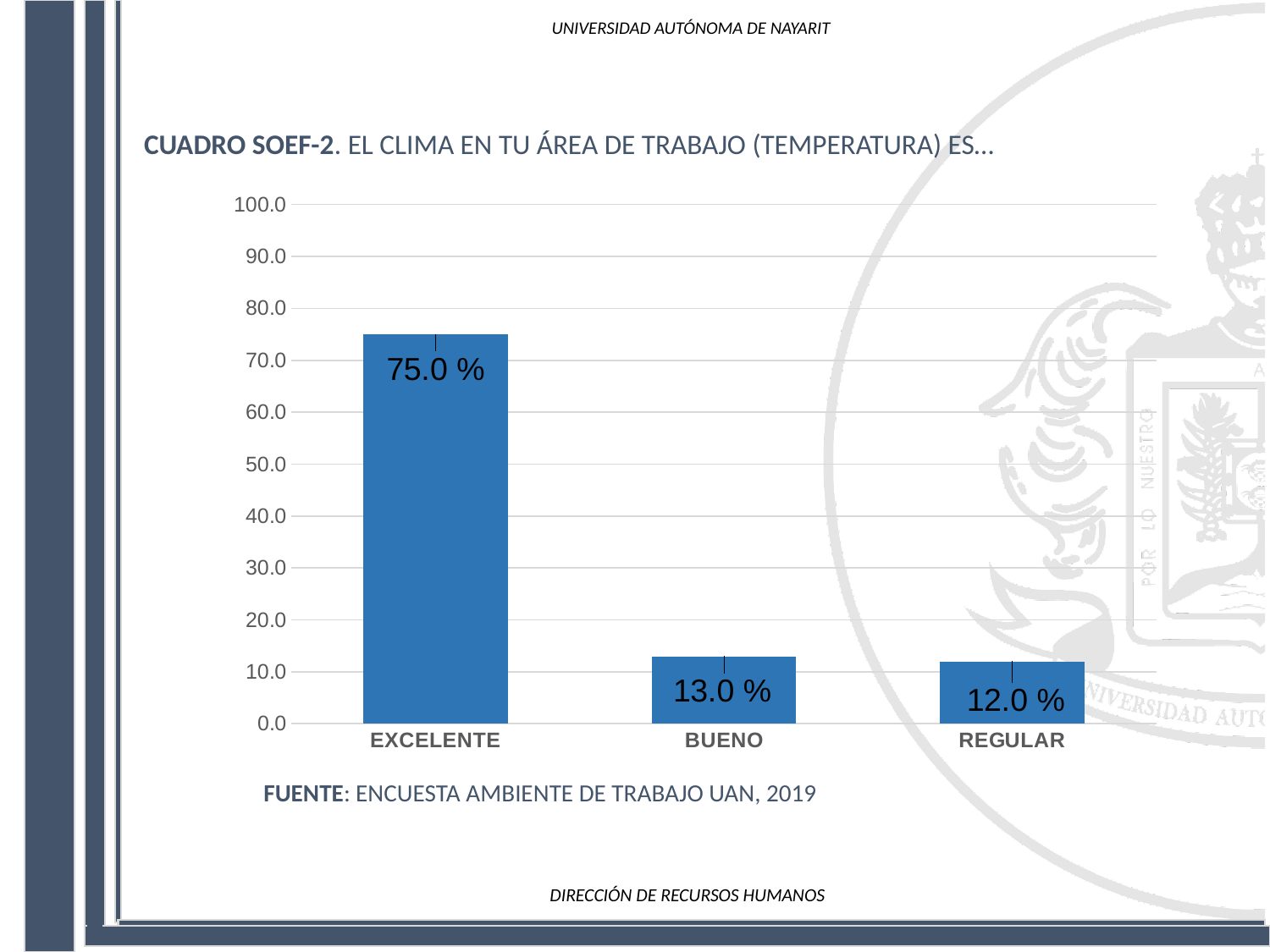
What is the difference between the values for BUENO and REGULAR? 1.0 % Which category has the lowest value? REGULAR Which category has the highest value? EXCELENTE Which is larger, the value for EXCELENTE or the value for REGULAR? EXCELENTE What is the value for BUENO? 13.0 % How many categories are shown on the x axis? 3 Is the value for EXCELENTE greater or less than 70.0? greater What is the difference between the values for EXCELENTE and BUENO? 62.0 % What kind of chart is shown on the slide? bar chart What is the value for REGULAR? 12.0 % What source is cited below the chart? ENCUESTA AMBIENTE DE TRABAJO UAN, 2019 What is the value for EXCELENTE? 75.0 %